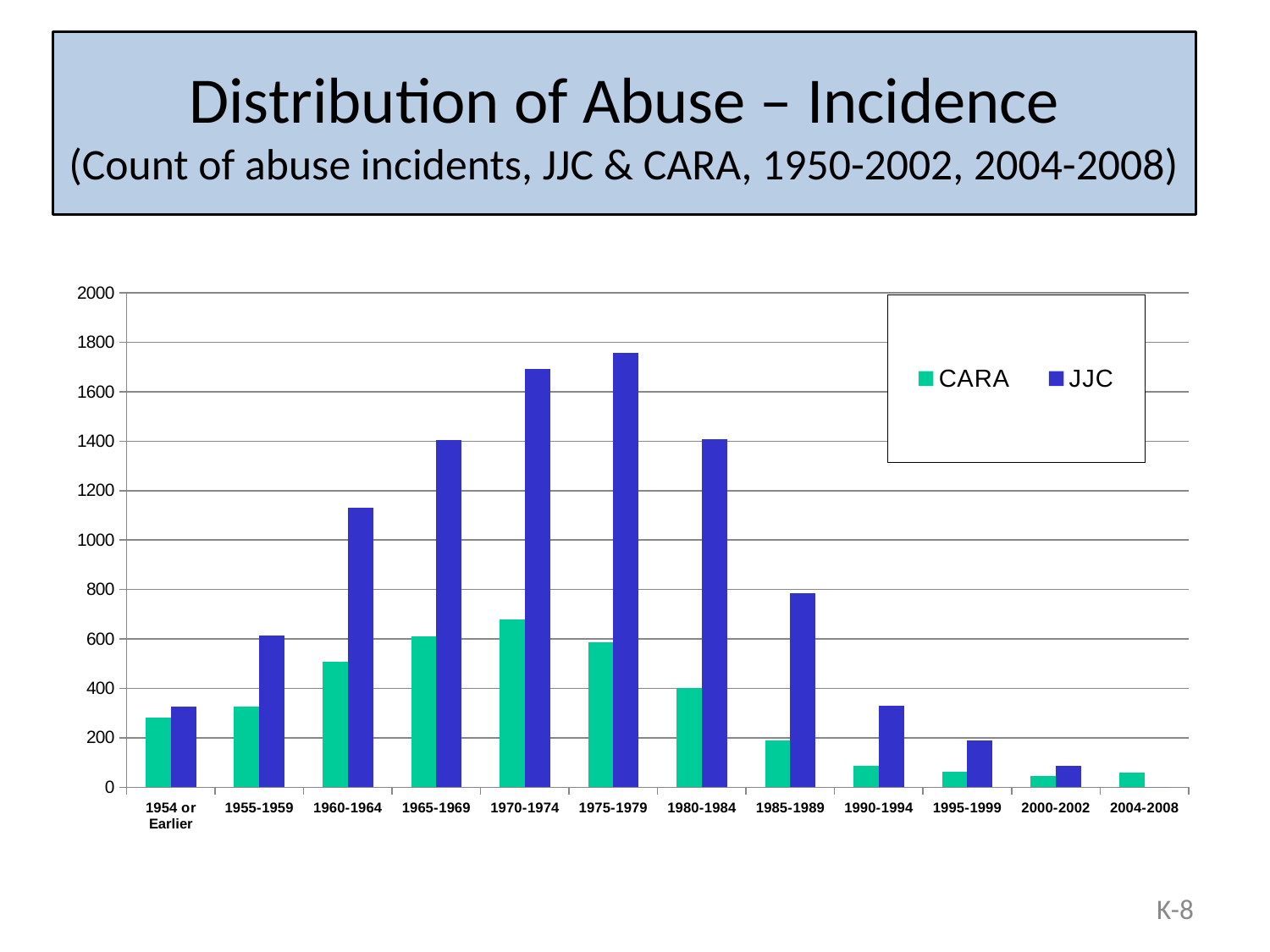
Which time period has the highest JJC value? 1975-1979 What kind of chart is shown on the slide? bar chart Do the JJC values rise or fall from 1975-1979 through 2000-2002? fall In 1975-1979, which series has the larger value, CARA or JJC? JJC Is the JJC value for 1990-1994 greater or less than 200? greater Is the JJC value for 1970-1974 greater or less than 1600? greater How many series does the legend list? 2 How many time-period categories are shown on the x axis? 12 Is the CARA value for 1960-1964 greater or less than 400? greater Which time period has the highest CARA value? 1970-1974 Which series is shown in blue in the legend? JJC